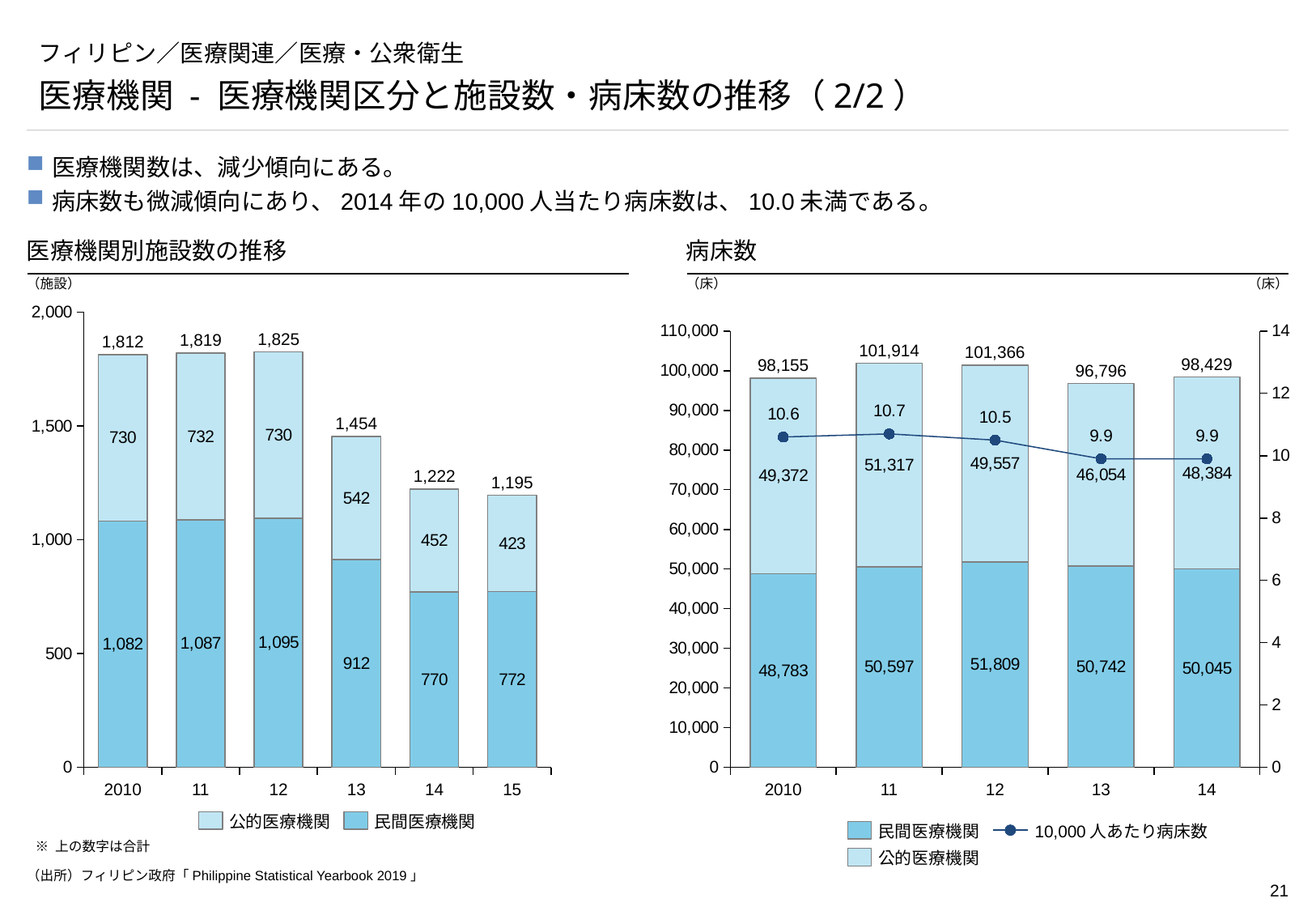
In the 医療機関別施設数の推移 chart, what is the total number of facilities in 2013? 1,454 In the 病床数 chart, which is larger in 2012: 民間医療機関 or 公的医療機関? 民間医療機関 In the 医療機関別施設数の推移 chart, how many years are shown on the x axis? 6 In the 病床数 chart, which year has the lowest total number of beds? 13 In the 医療機関別施設数の推移 chart, which year has the highest total number of facilities? 12 In the 医療機関別施設数の推移 chart, what is the value for 民間医療機関 in 2012? 1,095 In the 医療機関別施設数の推移 chart, what is the difference between the 公的医療機関 values for 2010 and 15? 307 In the 病床数 chart, what is the total number of beds in 2011? 101,914 What type of chart is the 医療機関別施設数の推移 chart? stacked bar chart In the 病床数 chart, how many series does the legend list? 3 In the 病床数 chart, what is the value of 10,000人あたり病床数 in 2014? 9.9 In the 医療機関別施設数の推移 chart, do the total values rise or fall from 2012 to 15? fall